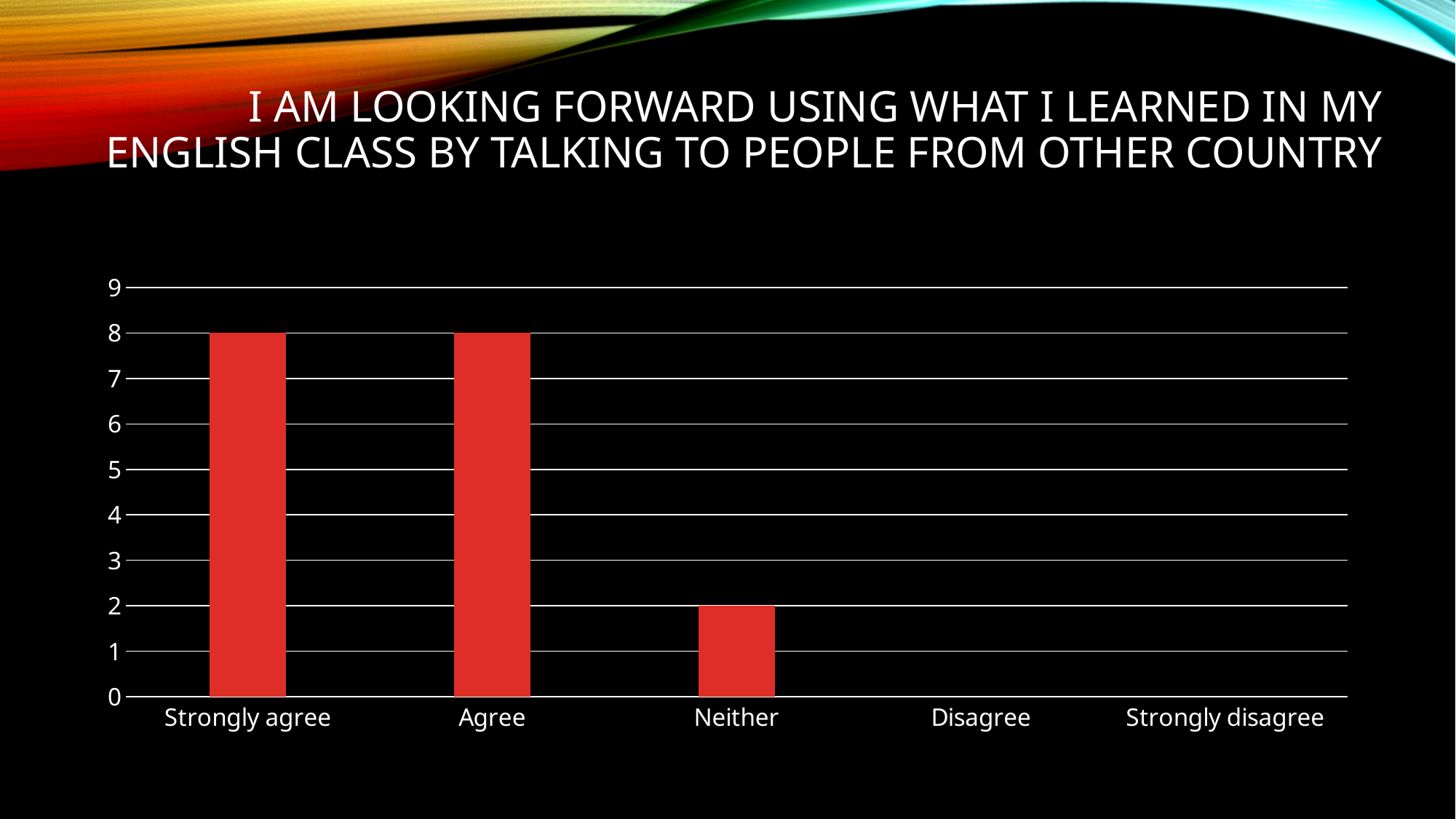
What is the difference between the value for Strongly agree and the value for Neither? 6 How many categories are shown on the x axis? 5 What is the value for Strongly disagree? 0 What colour are the bars in the chart? Red What is the value for Disagree? 0 What kind of chart is shown on the slide? Bar chart Is the value for Neither greater or less than 5? less Do the values generally rise or fall moving from Strongly agree to Strongly disagree along the x axis? Fall What is the value for Neither? 2 Which is larger, the value for Agree or the value for Neither? Agree What is the value for Agree? 8 What is the value for Strongly agree? 8